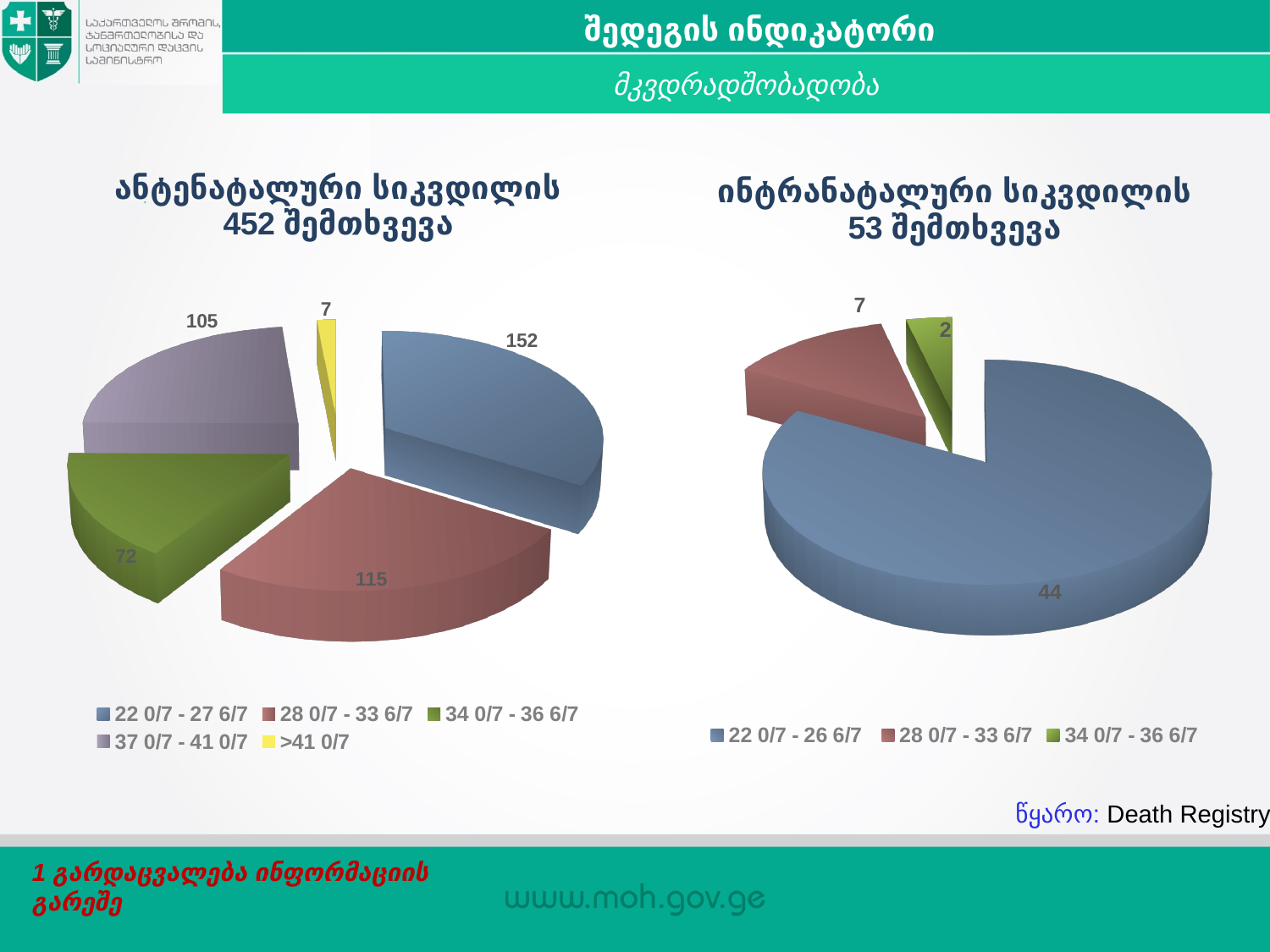
On the left pie chart, how many categories does the legend list? 5 On the right pie chart, which is larger: the 28 0/7 - 33 6/7 slice or the 34 0/7 - 36 6/7 slice? 28 0/7 - 33 6/7 On the left pie chart (ანტენატალური სიკვდილის 452 შემთხვევა), what is the value for the 22 0/7 - 27 6/7 slice? 152 What type of chart is used on the right side of the slide? Pie chart On the left pie chart, what is the difference between the 28 0/7 - 33 6/7 slice and the 37 0/7 - 41 0/7 slice? 10 On the right pie chart (ინტრანატალური სიკვდილის 53 შემთხვევა), what is the value for the 22 0/7 - 26 6/7 slice? 44 On the left pie chart, what is the value for the >41 0/7 slice? 7 On the right pie chart, what is the total of all slices? 53 On the left pie chart, what is the value for the 34 0/7 - 36 6/7 slice? 72 On the left pie chart, which category has the smallest slice? >41 0/7 On the right pie chart, what is the value for the 34 0/7 - 36 6/7 slice? 2 On the left pie chart, which category has the largest slice? 22 0/7 - 27 6/7